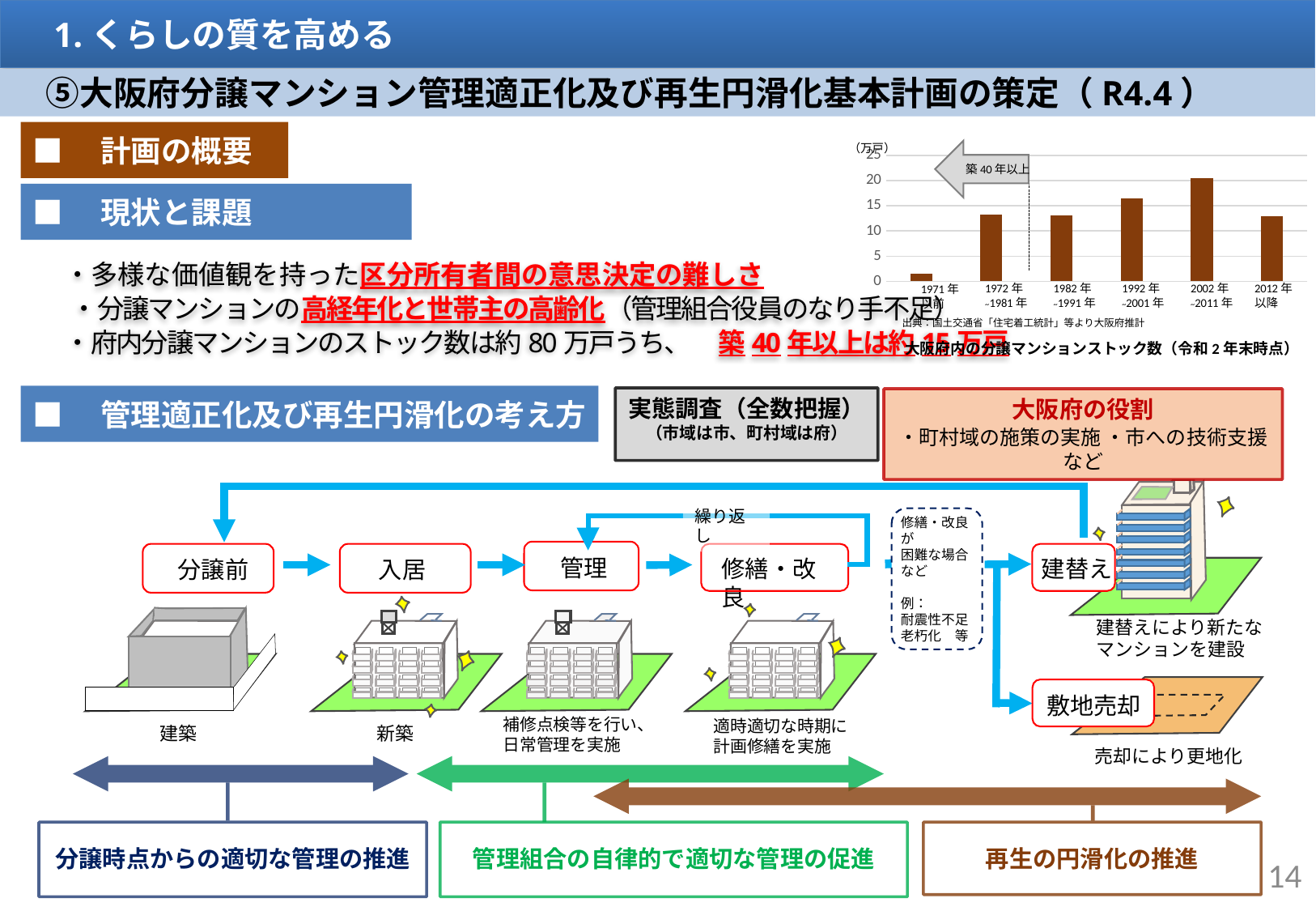
How many period categories are shown on the x axis of the bar chart? 6 Which period has the lowest bar in the bar chart? 1971年以前 Is the value for 1971年以前 in the bar chart greater or less than 5? less What is the title of the bar chart? 大阪府内の分譲マンションストック数（令和2年末時点） What kind of chart is shown in the upper right of the slide? bar chart In the bar chart, which is larger: the value for 1972年～1981年 or the value for 1971年以前? 1972年～1981年 Which period has the highest bar in the bar chart? 2002年～2011年 In the bar chart, which is larger: the value for 2002年～2011年 or the value for 1992年～2001年? 2002年～2011年 What unit is shown on the y axis of the bar chart? 万戸 Is the value for 2012年以降 in the bar chart greater or less than 15? less Is the value for 1992年～2001年 in the bar chart greater or less than 15? greater